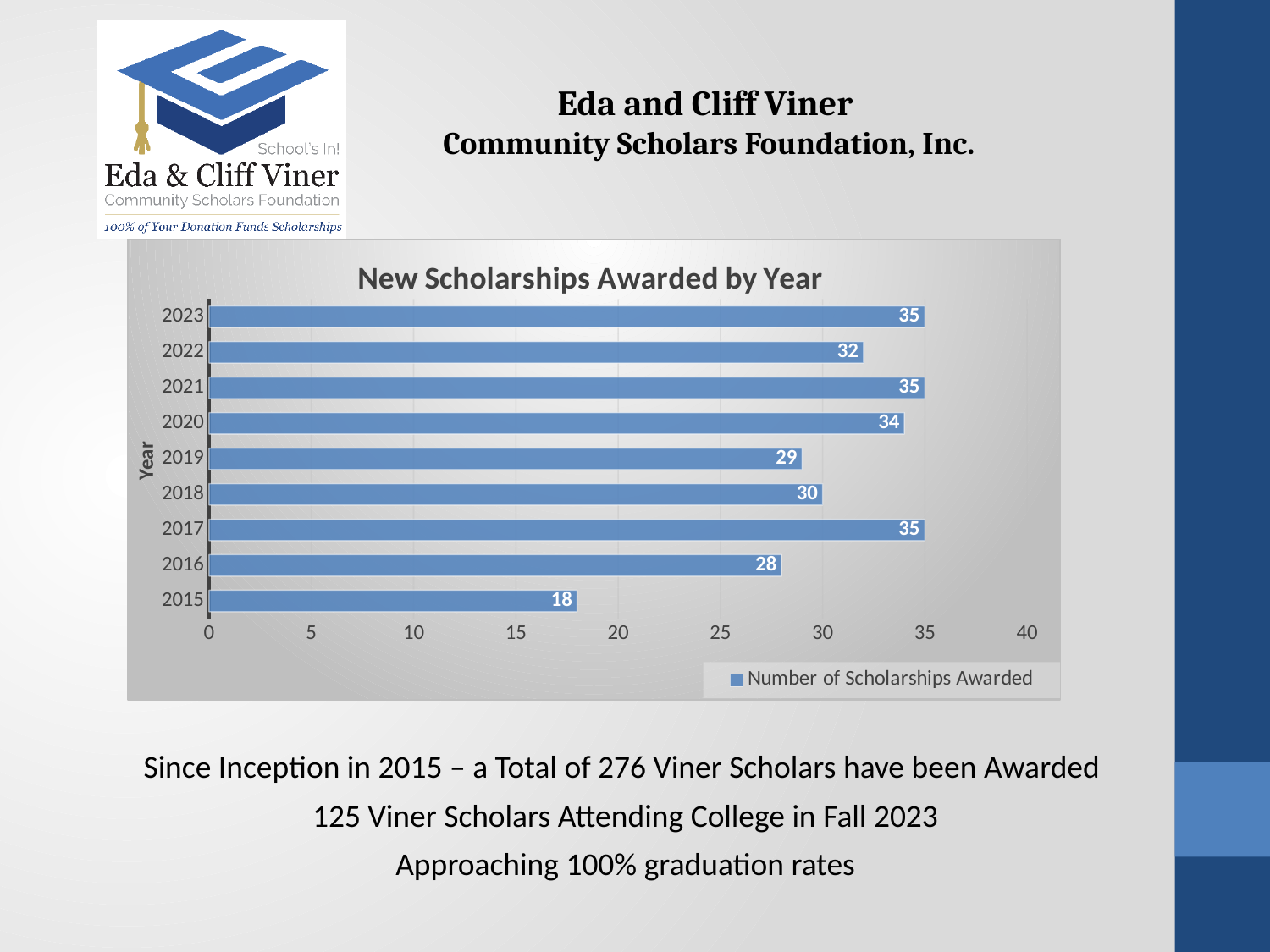
How many new scholarships were awarded in 2015? 18 How many series does the legend list? 1 Which year had the lowest number of new scholarships awarded? 2015 What is the difference between the number of scholarships awarded in 2018 and in 2019? 1 What type of chart is shown on the slide? bar chart What is the title of the chart? New Scholarships Awarded by Year What is the label of the series shown in the legend? Number of Scholarships Awarded Which year had more scholarships awarded, 2016 or 2018? 2018 How many years are shown on the chart? 9 How many new scholarships were awarded in 2022? 32 What is the difference between the number of scholarships awarded in 2023 and in 2015? 17 How many new scholarships were awarded in 2020? 34